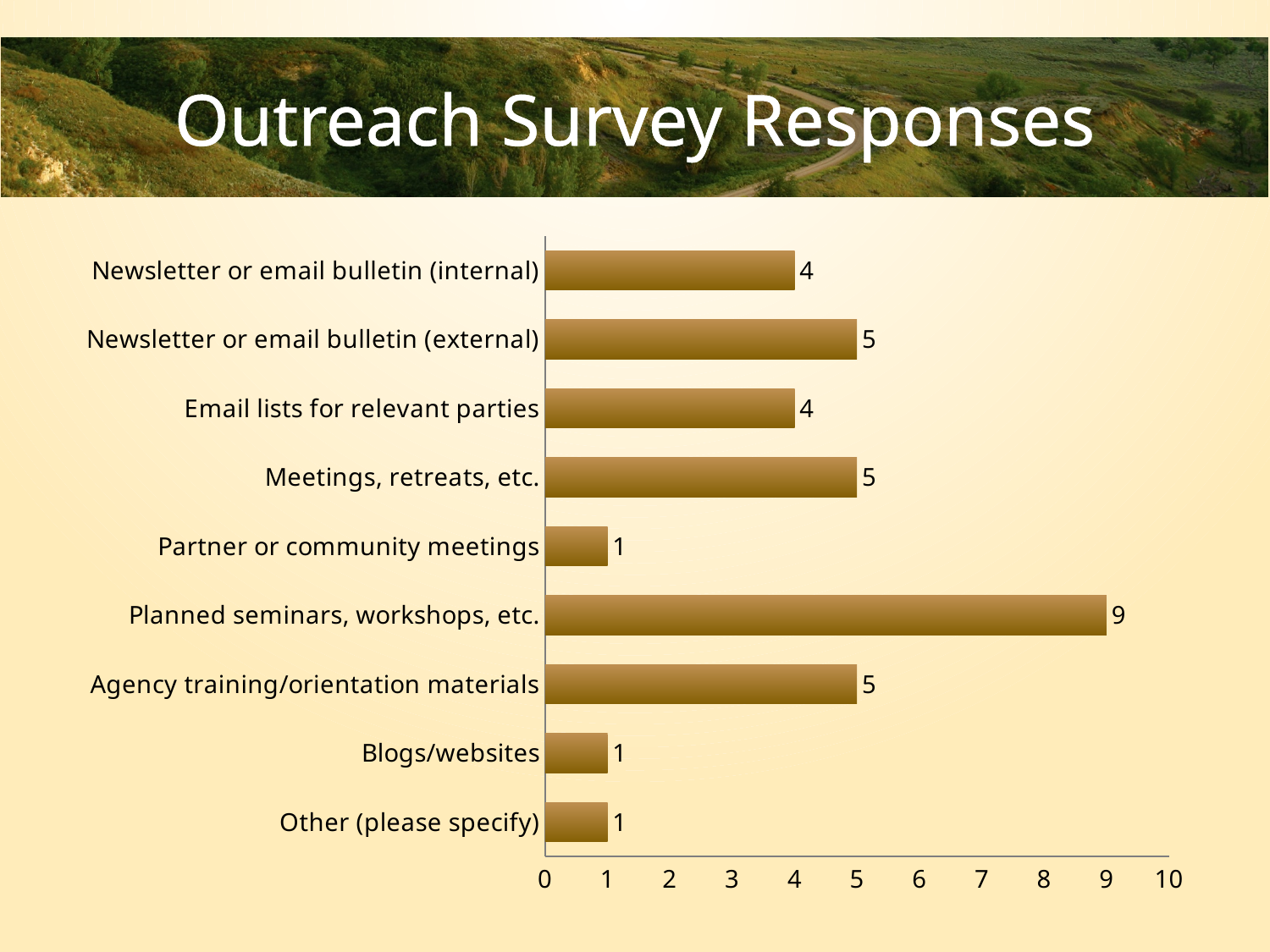
How many categories are shown in the chart? 9 What is the value for Planned seminars, workshops, etc.? 9 What is the maximum value shown on the horizontal axis? 10 What is the difference between the values for Planned seminars, workshops, etc. and Agency training/orientation materials? 4 Which category has the highest value? Planned seminars, workshops, etc. What kind of chart is shown on the slide? bar chart What is the value for Newsletter or email bulletin (external)? 5 What is the value for Partner or community meetings? 1 What is the title of the slide? Outreach Survey Responses Is the value for Planned seminars, workshops, etc. greater or less than 8? greater What is the value for Email lists for relevant parties? 4 Which is larger, the value for Meetings, retreats, etc. or the value for Blogs/websites? Meetings, retreats, etc.